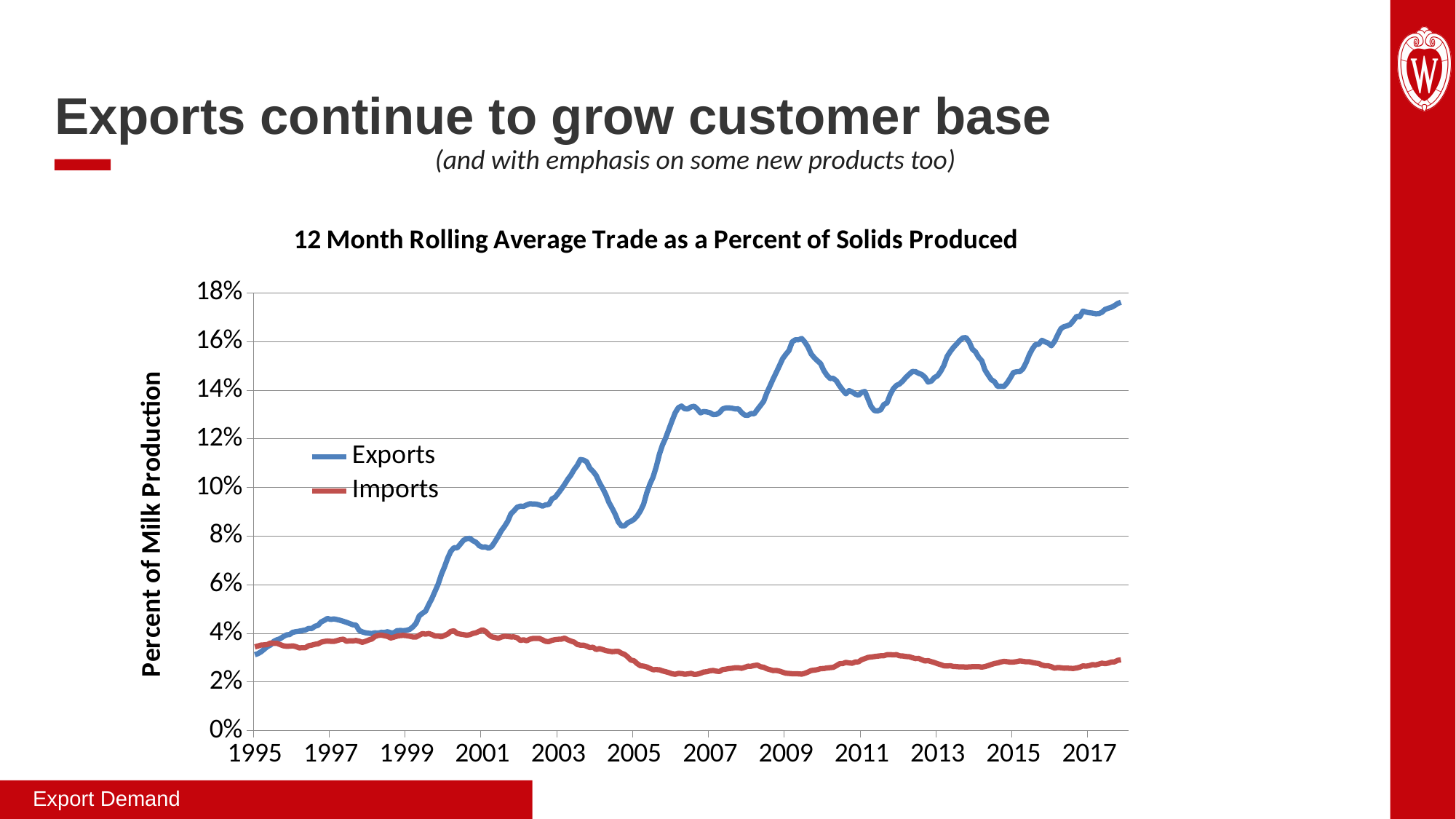
Is the Imports value in 2017 greater or less than 4%? less Which series has the higher value in 2017, Exports or Imports? Exports How many series does the legend list? 2 What is the title of the chart? 12 Month Rolling Average Trade as a Percent of Solids Produced Is the Exports value in 2017 greater or less than 16%? greater Do the Imports values rise or fall between 2003 and 2007? fall Is the Exports value in 1995 greater or less than 4%? less What is the label on the vertical axis of the chart? Percent of Milk Production Do the Exports values generally rise or fall from 1995 to 2017? rise What kind of chart is shown on the slide? line chart